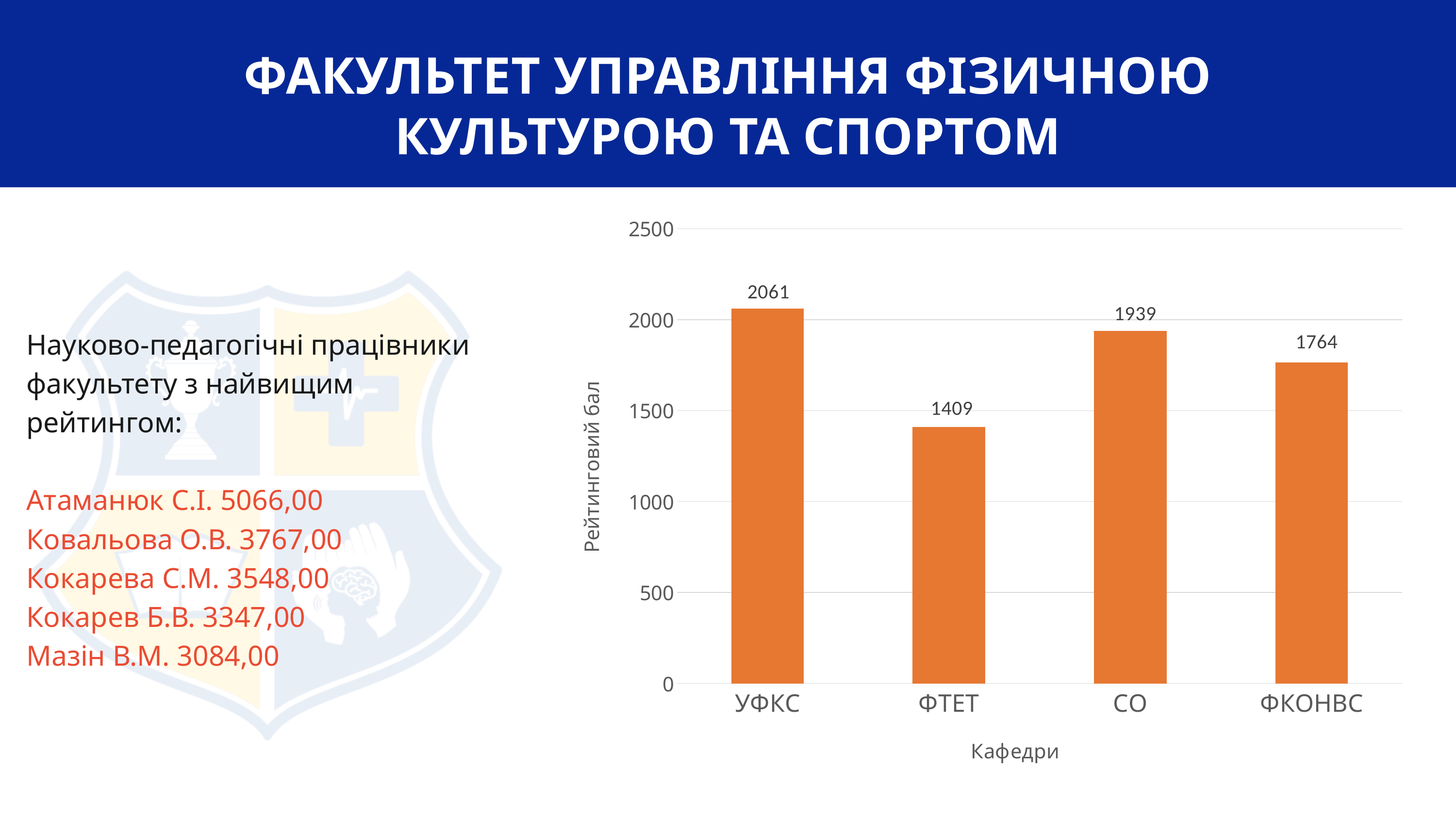
What is the difference between the rating scores of УФКС and ФТЕТ? 652 What is the rating score for ФКОНВС? 1764 What is the label of the vertical axis of the chart? Рейтинговий бал What is the rating score for ФТЕТ? 1409 Which department has the lowest rating score? ФТЕТ Which department (кафедра) has the highest rating score? УФКС What is the rating score for СО? 1939 What is the rating score (Рейтинговий бал) for УФКС? 2061 What is the difference between the rating scores of СО and ФКОНВС? 175 What kind of chart is shown on the slide? Bar chart How many departments are shown on the chart? 4 Which has a higher rating score, СО or ФКОНВС? СО